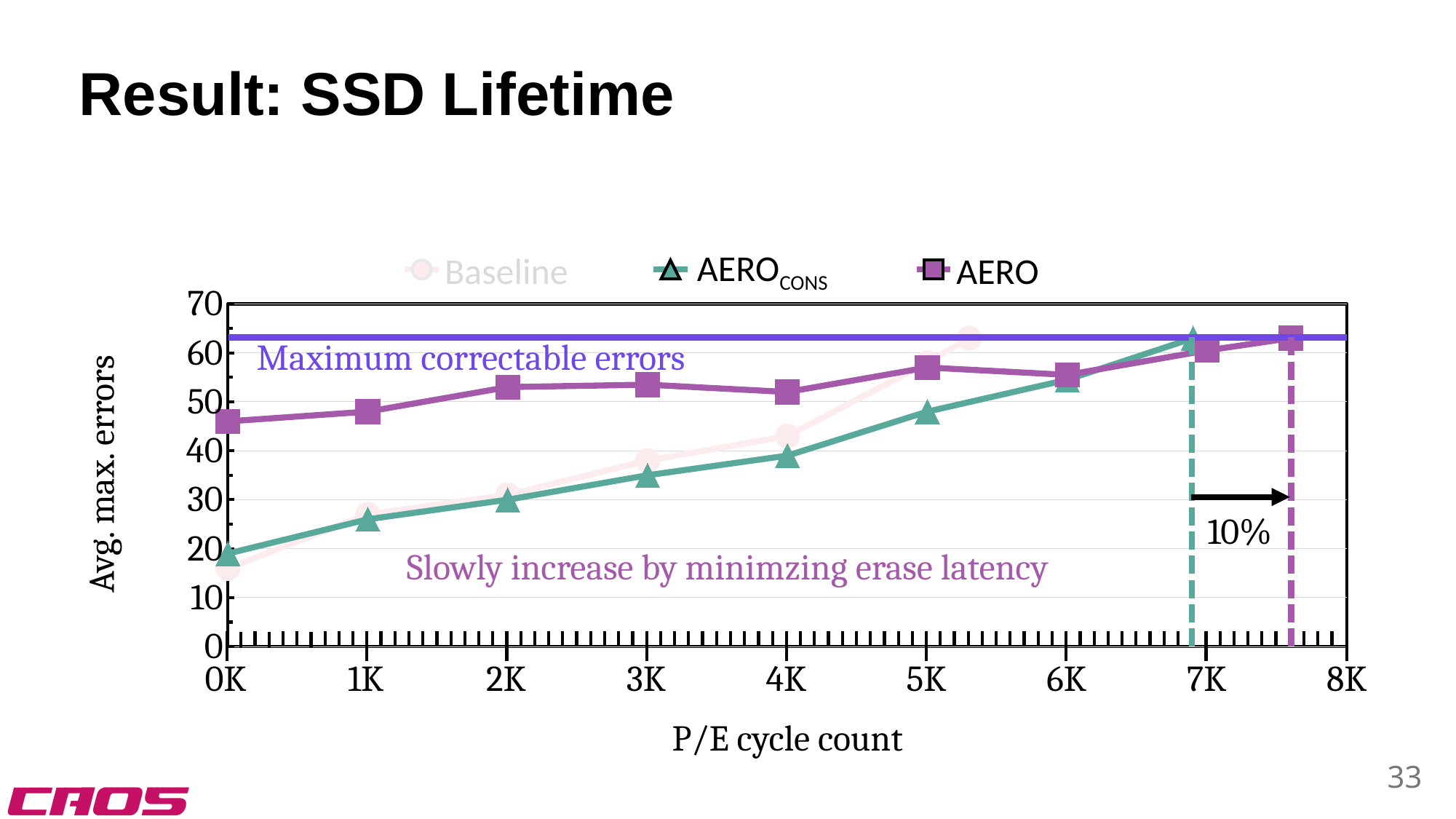
Do the values for AERO_CONS rise or fall as the P/E cycle count increases? rise What kind of chart is shown on the slide? line chart Is the value for AERO at 2K greater or less than 50? greater Is the value for AERO at 5K greater or less than 50? greater Is the value for AERO_CONS at 0K greater or less than 30? less What is the label of the x axis? P/E cycle count At 0K P/E cycles, which series has the larger value, AERO or Baseline? AERO At 2K P/E cycles, which series has the larger value, AERO or AERO_CONS? AERO How many series does the legend list? 3 What is the label of the y axis? Avg. max. errors